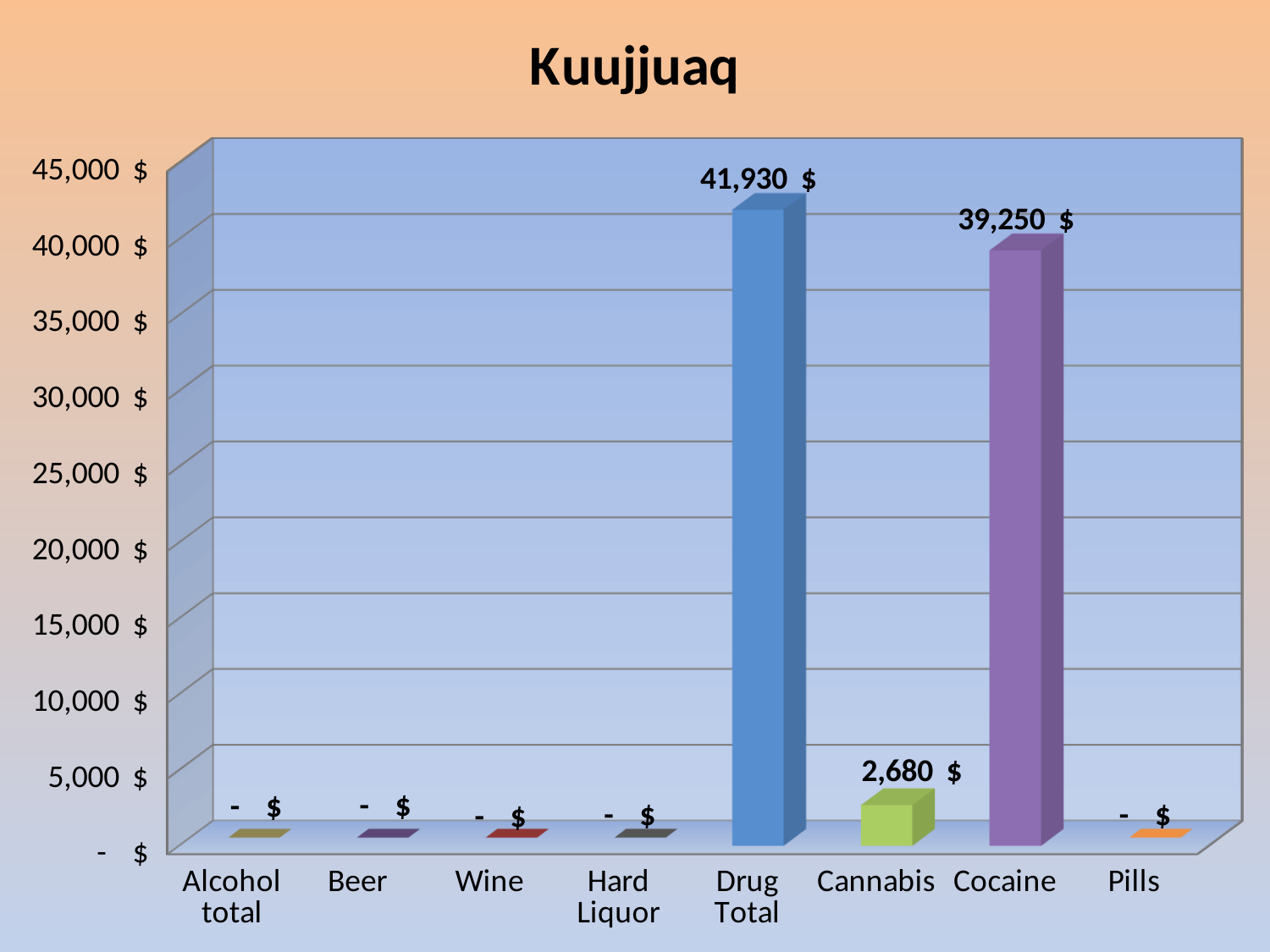
What is the title of the chart? Kuujjuaq What is the difference between Cocaine and Cannabis? 36,570 $ What is the difference between Drug Total and Cocaine? 2,680 $ What is the value for Cocaine? 39,250 $ What is the value for Drug Total? 41,930 $ What kind of chart is this? bar chart How many categories are shown on the x axis? 8 Which is larger, Cocaine or Cannabis? Cocaine What is the value shown for Beer? - $ What is the value for Cannabis? 2,680 $ Which category has the highest value? Drug Total Is the value for Cocaine greater or less than 35,000 $? greater